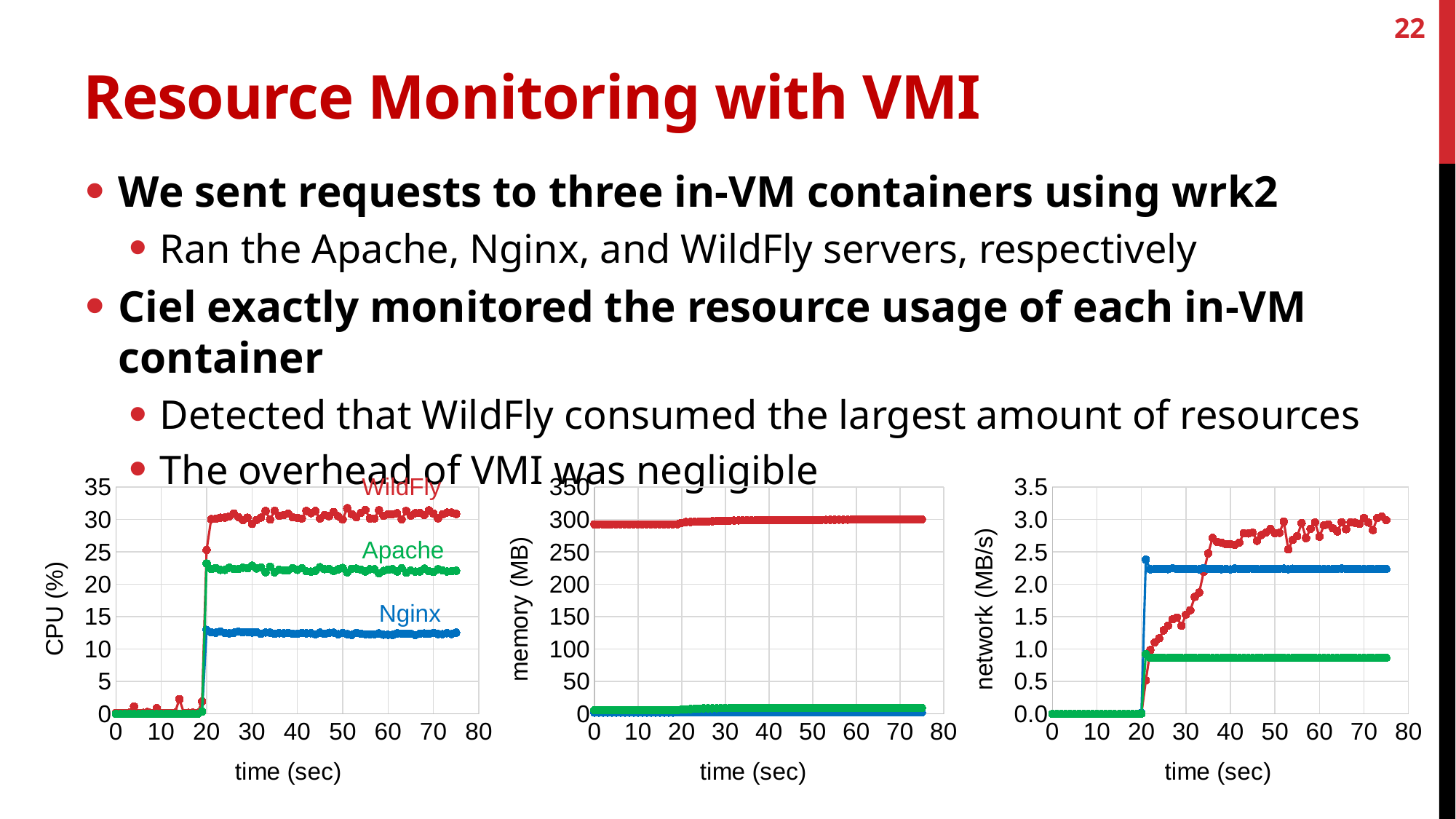
In the CPU (%) chart, is the CPU usage of Nginx after 20 seconds greater or less than 15? less In the network (MB/s) chart, is the value of the green (Apache) line after 20 seconds greater or less than 1.0? less In the CPU (%) chart, which server has the highest CPU usage after 20 seconds? WildFly In the network (MB/s) chart, is the value of the blue (Nginx) line after 25 seconds greater or less than 2.0? greater In the CPU (%) chart, which server has the lowest CPU usage after 20 seconds? Nginx In the CPU (%) chart, how many series are plotted? 3 What is the y-axis label of the middle chart? memory (MB) In the CPU (%) chart, which is larger after 20 seconds: the CPU usage of Apache or of Nginx? Apache What kind of chart is the leftmost chart (CPU (%) vs time)? line chart In the network (MB/s) chart, does the red (WildFly) line rise or fall between 20 and 75 seconds? rise